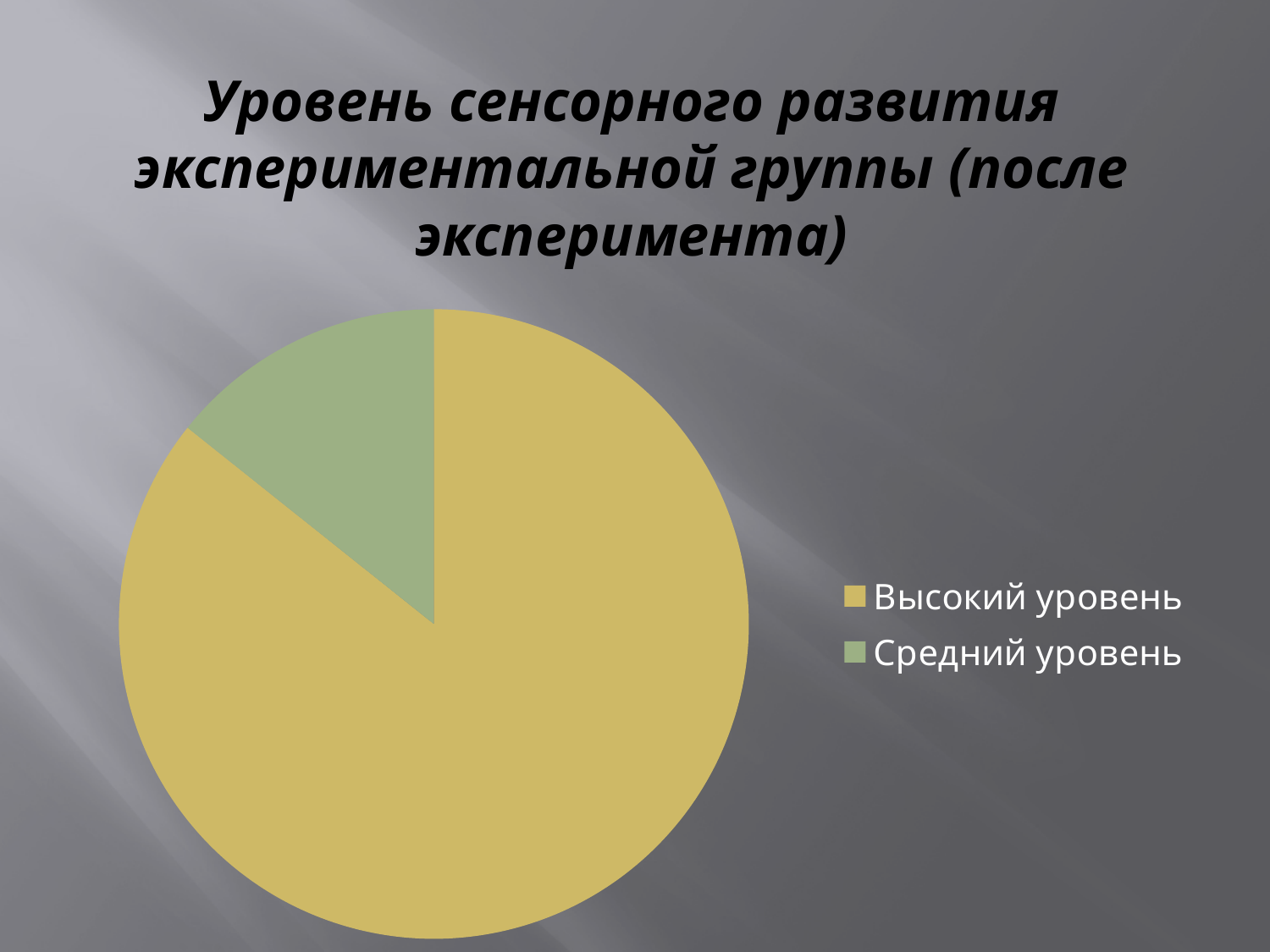
What colour is the slice for Средний уровень? green Which slice is larger: Высокий уровень or Средний уровень? Высокий уровень How many slices does the pie chart have? 2 How many entries does the legend list? 2 What is the title of the chart? Уровень сенсорного развития экспериментальной группы (после эксперимента) What kind of chart is shown on the slide? pie chart Which category has the smallest slice of the pie? Средний уровень Which category has the largest slice of the pie? Высокий уровень